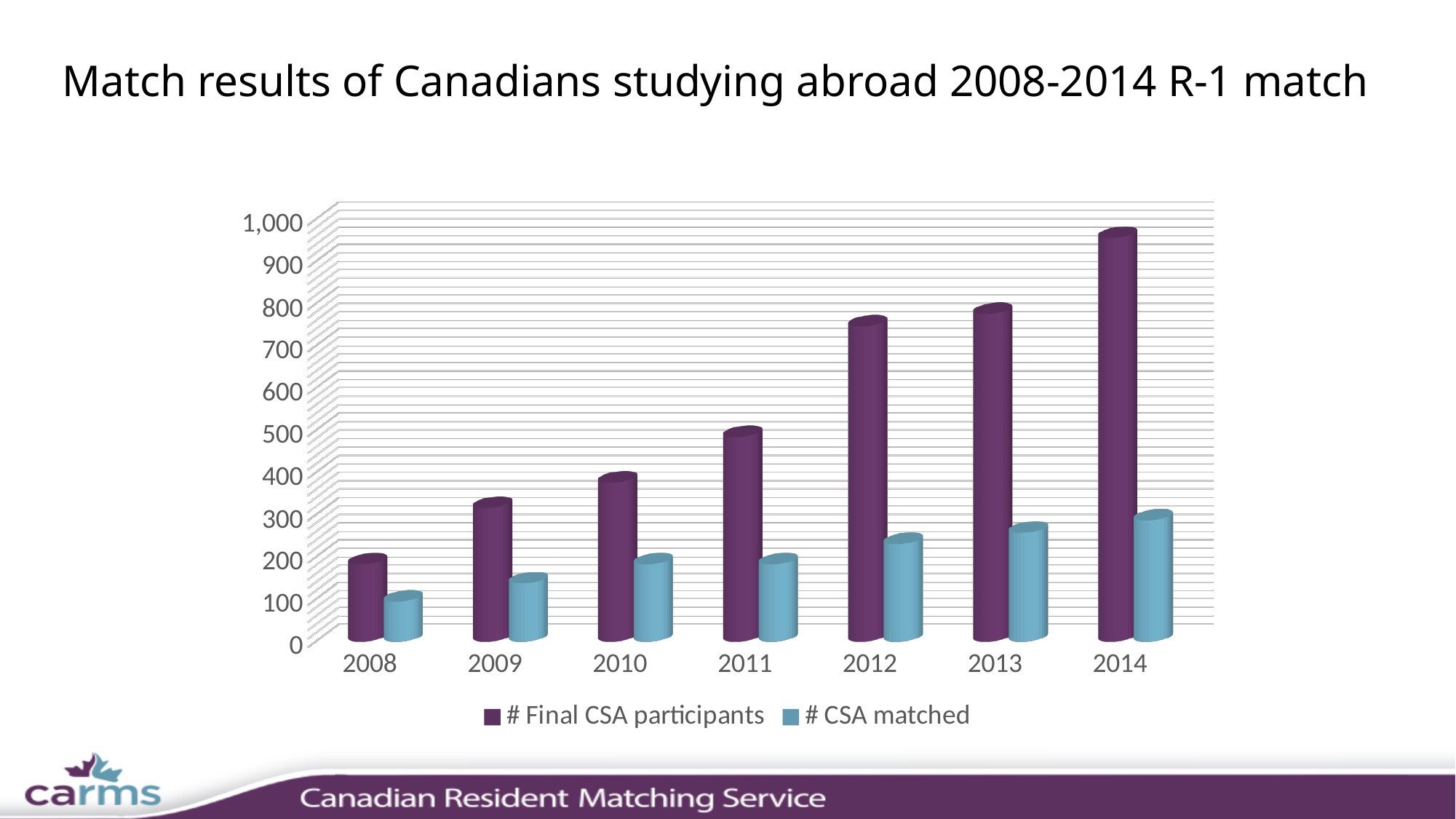
Is the number of final CSA participants in 2012 greater or less than 700? greater Which is larger: the number of final CSA participants in 2011 or in 2012? 2012 How many series does the legend list? 2 Is the number of CSA matched in 2013 greater or less than 200? greater Is the number of CSA matched in 2008 greater or less than 200? less How many years are shown on the x axis? 7 Do the number of final CSA participants rise or fall from 2008 to 2014? rise Which year has the highest number of final CSA participants? 2014 Which year has the lowest number of CSA matched? 2008 What kind of chart is shown on the slide? bar chart